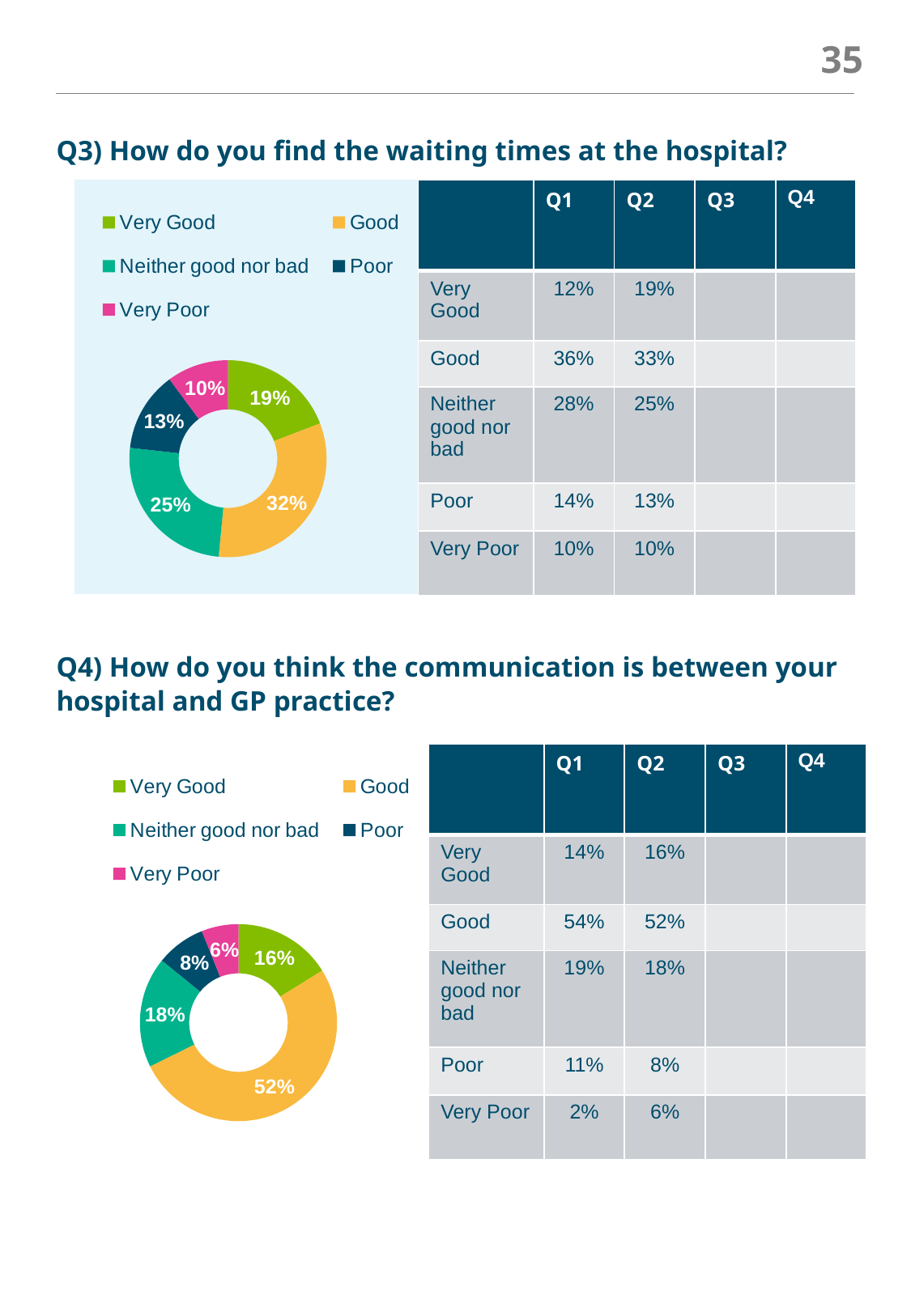
In the bottom chart (Q4, communication between hospital and GP practice), which is larger, Very Good or Neither good nor bad? Neither good nor bad In the top chart (Q3, waiting times at the hospital), what percentage is shown for the Good slice? 32% In the bottom chart (Q4, communication between hospital and GP practice), what is the difference between the Good and Very Good slices? 36% In the top chart (Q3, waiting times at the hospital), which category has the smallest slice? Very Poor In the top chart (Q3, waiting times at the hospital), what is the difference between the Very Good and Poor slices? 6% In the top chart (Q3, waiting times at the hospital), how many slices does the chart have? 5 In the top chart (Q3, waiting times at the hospital), what percentage is shown for Neither good nor bad? 25% In the top chart (Q3, waiting times at the hospital), which category has the largest slice? Good In the bottom chart (Q4, communication between hospital and GP practice), what percentage is shown for Very Poor? 6% In the bottom chart (Q4, communication between hospital and GP practice), how many entries does the legend list? 5 What type of chart is used for Q3 (waiting times at the hospital)? Doughnut (pie) chart In the bottom chart (Q4, communication between hospital and GP practice), what percentage is shown for the Good slice? 52%